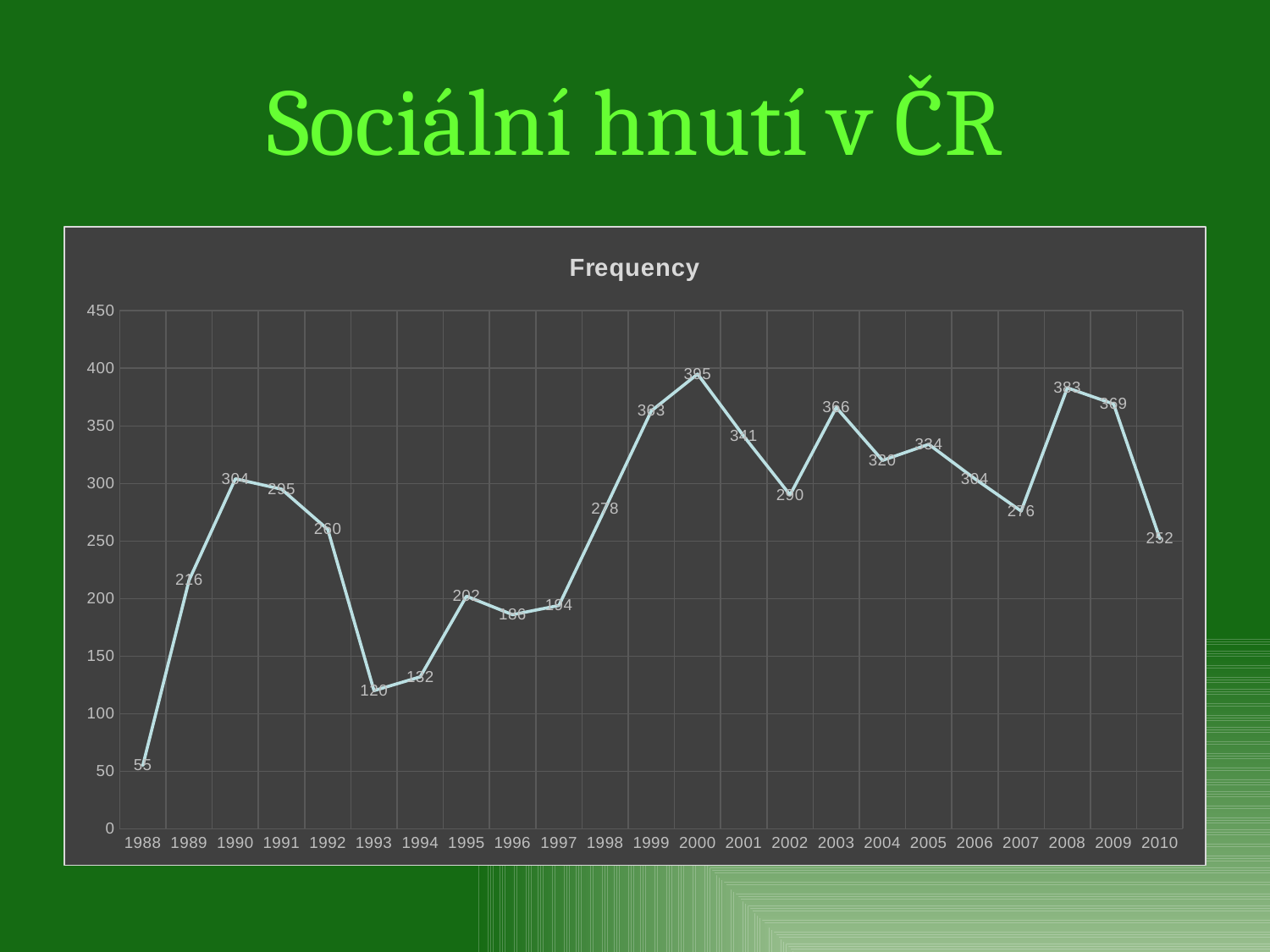
What is the value for 1989? 216 What is the value for 1998? 278 Which year has the lowest value? 1988 What is the difference between the values for 2003 and 2002? 76 Which year has the highest value? 2000 What is the value for 2003? 366 Which is larger, the value for 1998 or the value for 1995? 1998 How many years are plotted on the x axis? 23 What is the value for 1988? 55 Is the value for 1993 greater or less than 150? less What kind of chart is shown on the slide? line chart What is the title of the chart? Frequency